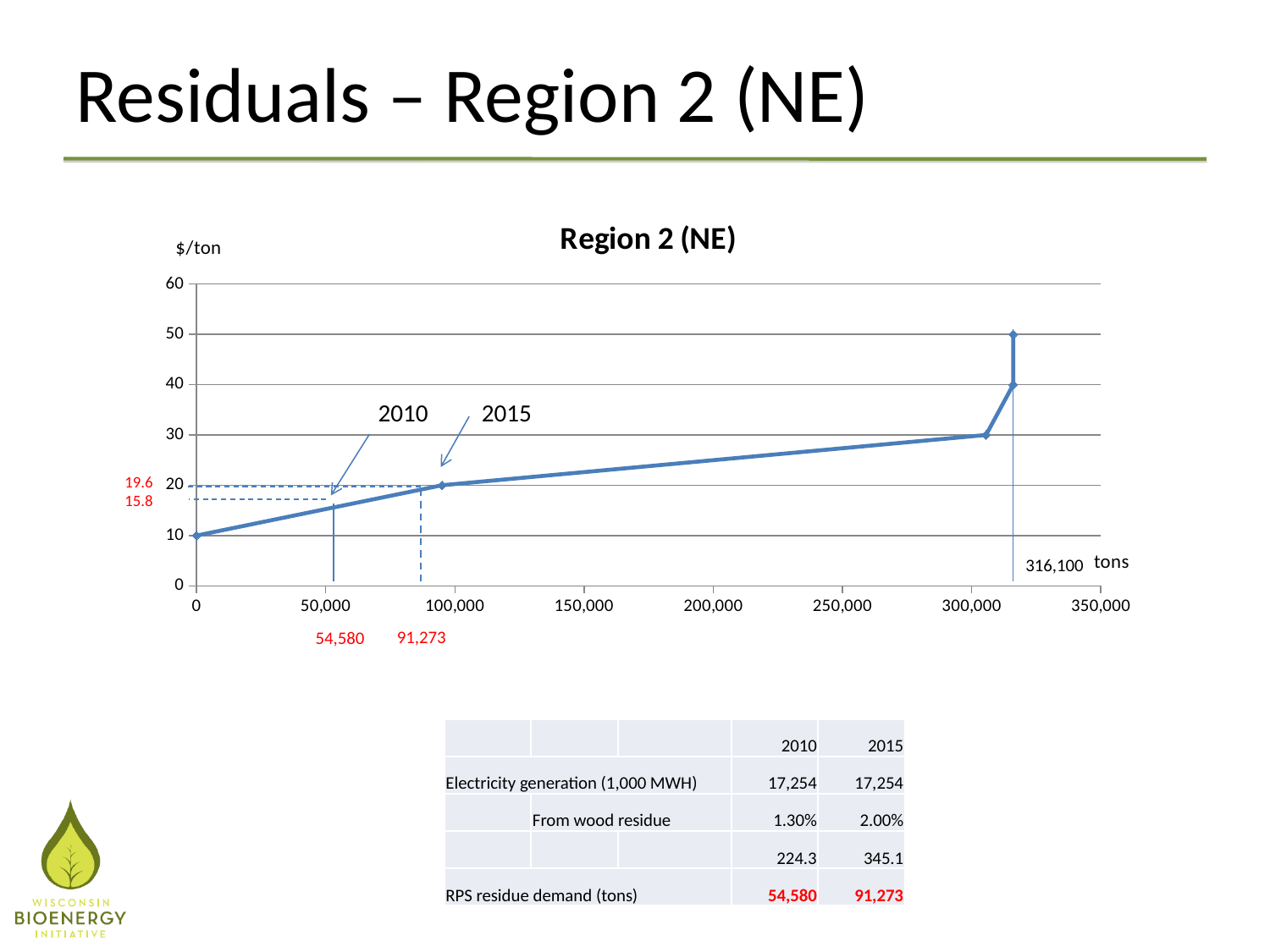
What is the label on the vertical axis of the chart? $/ton What tonnage is annotated at the vertical segment on the right side of the line? 316,100 What kind of chart is shown on the slide? line chart According to the chart annotations, what is the $/ton value marked for 2010? 15.8 What is the title of the chart? Region 2 (NE) What is the difference in $/ton between the 2015 and 2010 marked values? 3.8 What is the difference in tons between the 2015 and 2010 marked values? 36,693 How many tons are marked on the chart for 2010? 54,580 Which year has the higher marked $/ton value, 2010 or 2015? 2015 How many tons are marked on the chart for 2015? 91,273 According to the chart annotations, what is the $/ton value marked for 2015? 19.6 Does the $/ton value rise or fall as tons increase along the x axis? rise